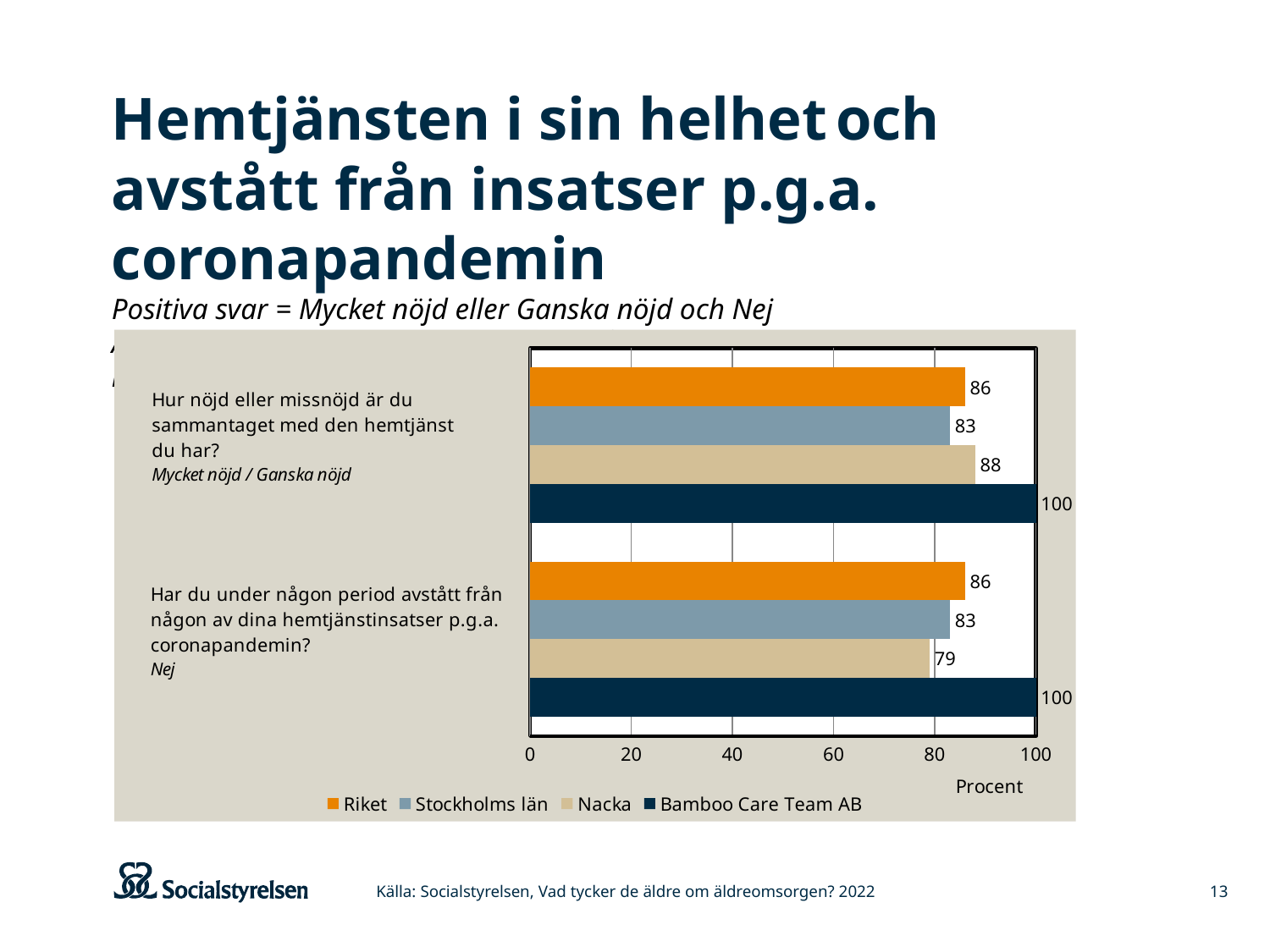
How many question categories are shown on the chart? 2 What type of chart is shown on the slide? bar chart What is the value for Stockholms län on the question about refraining from home care services due to the corona pandemic? 83 Which series has the highest value on the question about refraining from home care services due to the corona pandemic? Bamboo Care Team AB What unit is shown on the x axis of the chart? Procent How many series does the legend list? 4 Which series has the lowest value on the question about refraining from home care services due to the corona pandemic? Nacka What is the value for Bamboo Care Team AB on the question about overall satisfaction with home care? 100 What is the value for Nacka on the question about having refrained from home care services due to the corona pandemic (Har du under någon period avstått från någon av dina hemtjänstinsatser p.g.a. coronapandemin?)? 79 Which is larger on the question about overall satisfaction with home care: Riket or Nacka? Nacka What is the difference between Bamboo Care Team AB and Nacka on the question about refraining from home care services due to the corona pandemic? 21 What is the value for Nacka on the question about how satisfied you are overall with your home care (Hur nöjd eller missnöjd är du sammantaget med den hemtjänst du har?)? 88